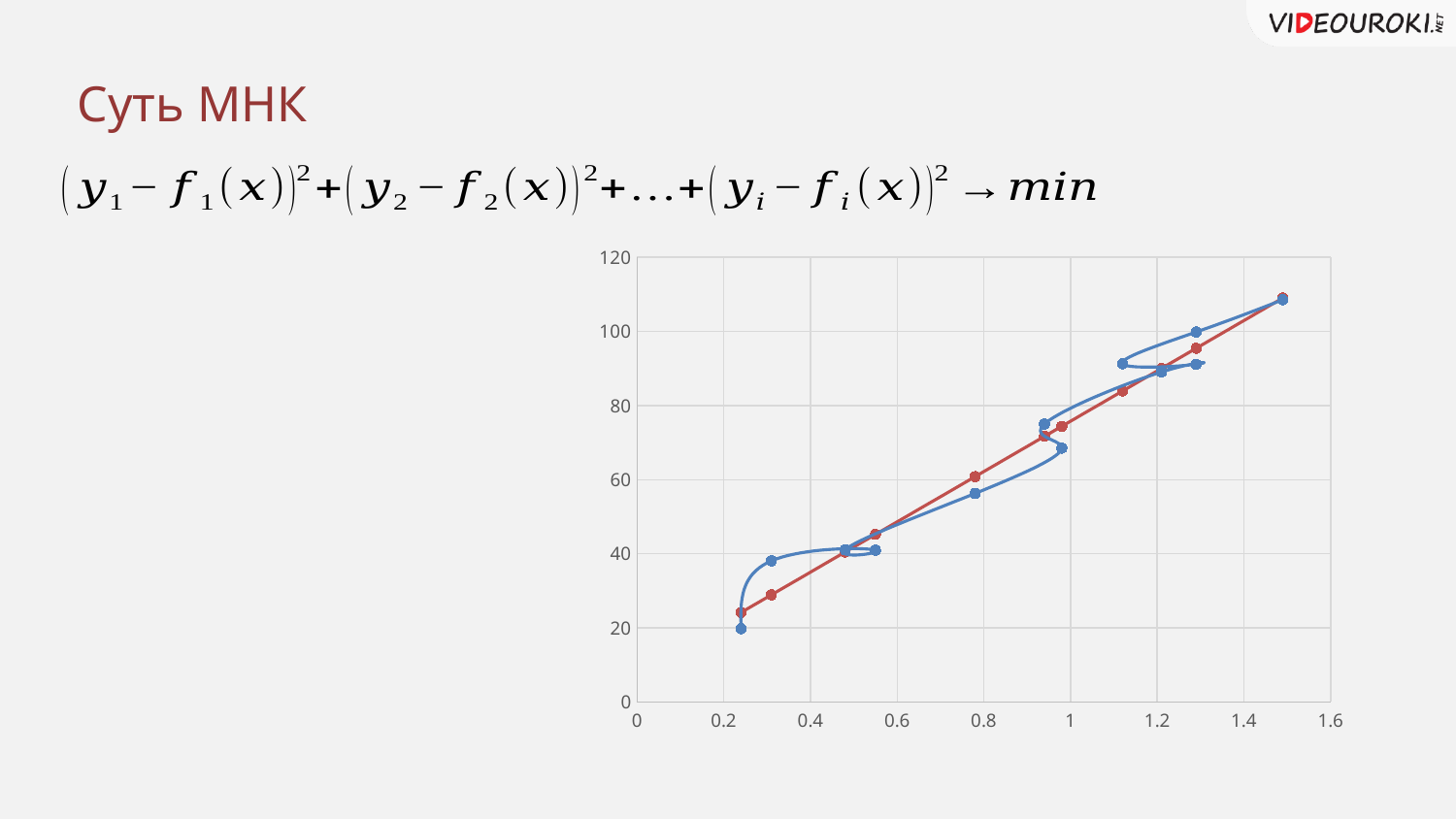
Is the value of the rightmost point (near x = 1.5) greater or less than 100? greater What is the highest tick value shown on the y axis of the chart? 120 Is the value of the lowest blue point (near x = 0.24) greater or less than 40? less Is the value of the blue point near x = 0.8 greater or less than 40? greater How many lines are plotted on the chart? 2 Near x = 0.3, which line has the higher value, the blue one or the red one? blue Do the plotted values rise or fall as x increases along the x axis? rise What kind of chart is shown on the slide? line chart